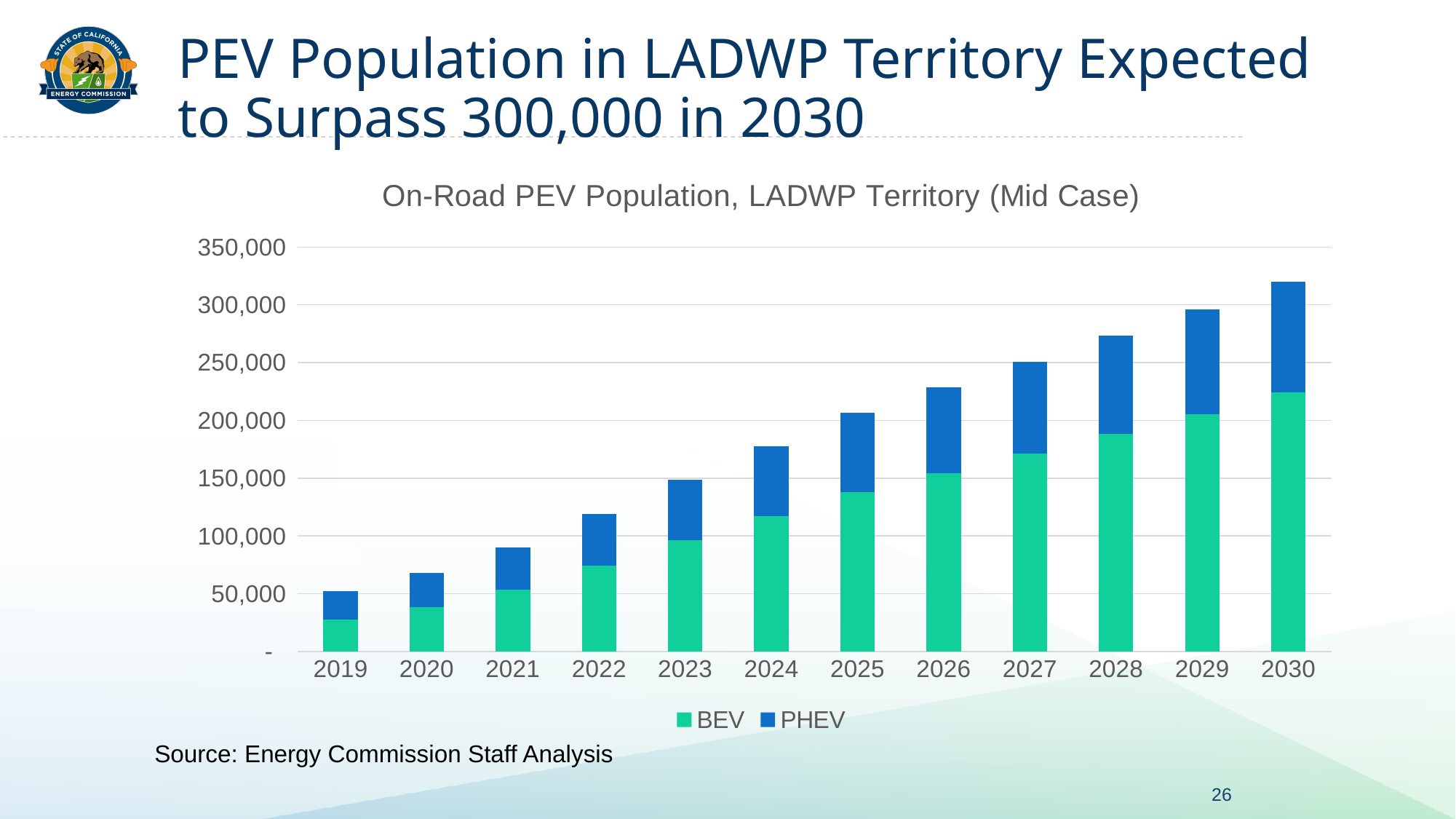
Is the total PEV population for 2024 greater or less than 200,000? less Which colour represents PHEV in the chart? Blue Is the BEV value for 2030 greater or less than 200,000? greater In 2030, which series is larger, BEV or PHEV? BEV Which year has the highest total PEV population? 2030 Which year has the lowest total PEV population? 2019 What kind of chart is shown on the slide? Stacked bar chart Do the total PEV population values rise or fall from 2019 to 2030? Rise How many years are shown on the x axis? 12 Is the total PEV population for 2030 greater or less than 300,000? greater What is the title of the chart? On-Road PEV Population, LADWP Territory (Mid Case) How many series does the legend list? 2